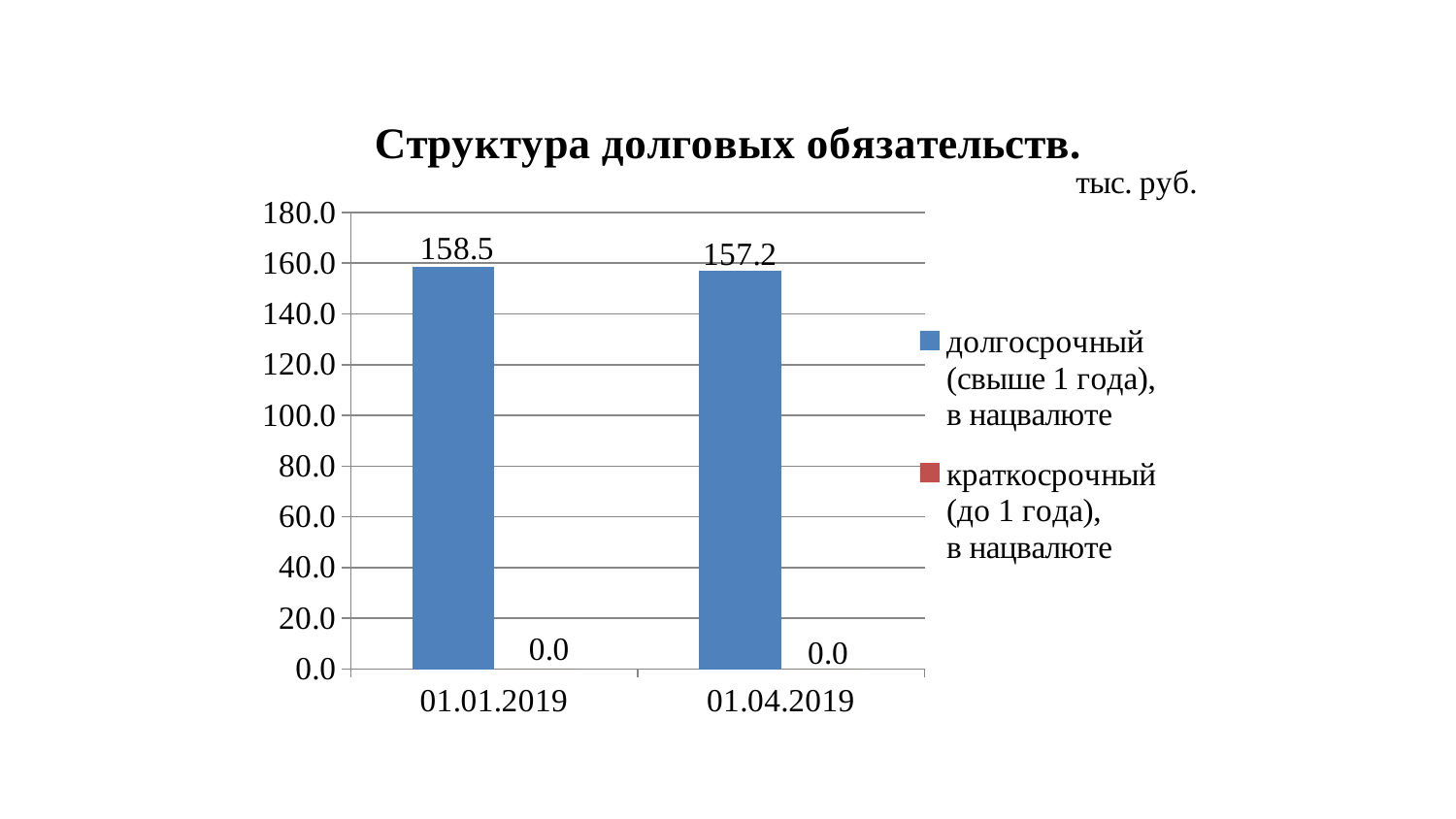
Is the долгосрочный value on 01.04.2019 greater or less than 160.0? less Does the долгосрочный value rise or fall from 01.01.2019 to 01.04.2019? fall What kind of chart is shown on the slide? bar chart What is the title of the chart? Структура долговых обязательств. How many dates are shown on the x axis? 2 What is the value of долгосрочный (свыше 1 года), в нацвалюте on 01.04.2019? 157.2 What is the value of краткосрочный (до 1 года), в нацвалюте on 01.04.2019? 0.0 Which date has the higher долгосрочный (свыше 1 года) value? 01.01.2019 What is the difference between the долгосрочный values on 01.01.2019 and 01.04.2019? 1.3 What is the value of долгосрочный (свыше 1 года), в нацвалюте on 01.01.2019? 158.5 How many series does the legend list? 2 What is the value of краткосрочный (до 1 года), в нацвалюте on 01.01.2019? 0.0